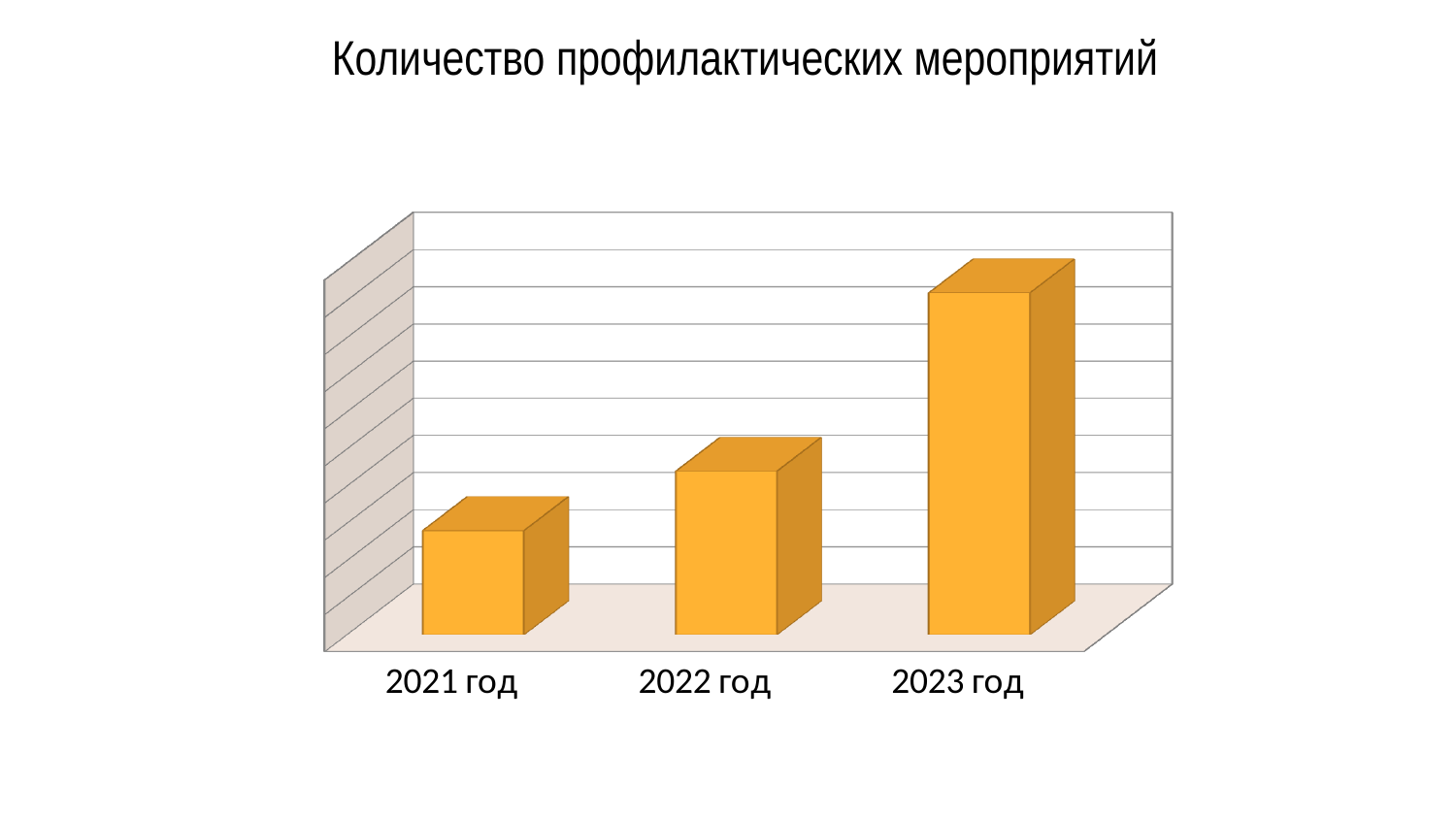
What kind of chart is shown on the slide? bar chart Which is larger, the value for 2023 год or the value for 2022 год? 2023 год Which year has the lowest value? 2021 год What is the label of the first category on the x axis? 2021 год What colour are the bars in the chart? orange Do the values rise or fall from 2021 год to 2023 год? rise How many categories (years) are shown on the x axis? 3 Which year has the highest value? 2023 год What is the title of the chart? Количество профилактических мероприятий Which is larger, the value for 2022 год or the value for 2021 год? 2022 год